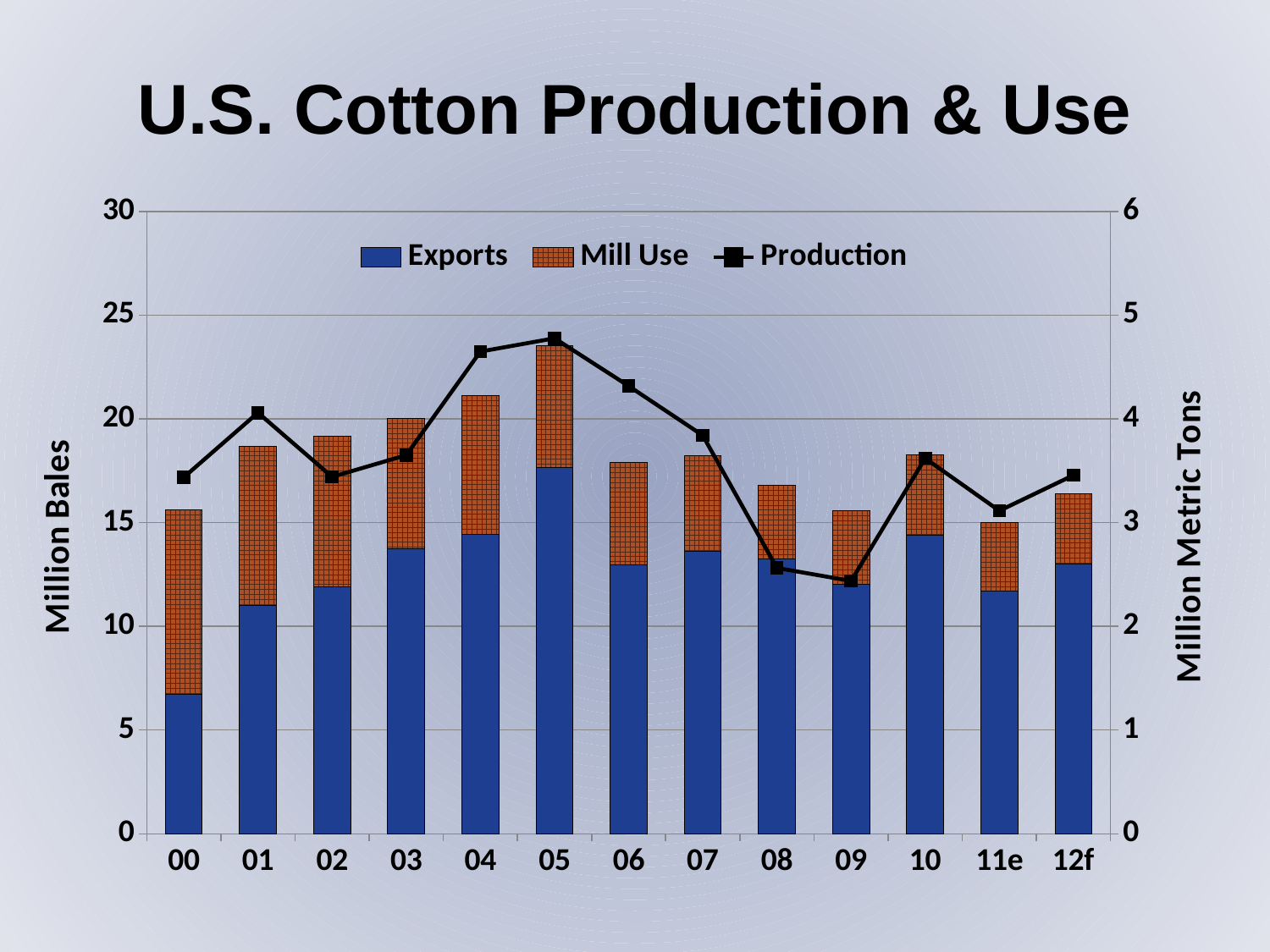
Is the Exports value for 00 greater or less than 10 million bales? less Which year has the lowest Exports value? 00 Does the Production line rise or fall from 05 to 09? fall Is the Production value for 05 greater or less than 4 million metric tons? greater Is the Exports value for 05 greater or less than 15 million bales? greater Which is larger, Production in 04 or Production in 08? 04 What kind of chart is this? Stacked bar chart with a line What is the title of the chart? U.S. Cotton Production & Use How many years are shown on the x axis? 13 How many series does the legend list? 3 Which year has the highest Exports value? 05